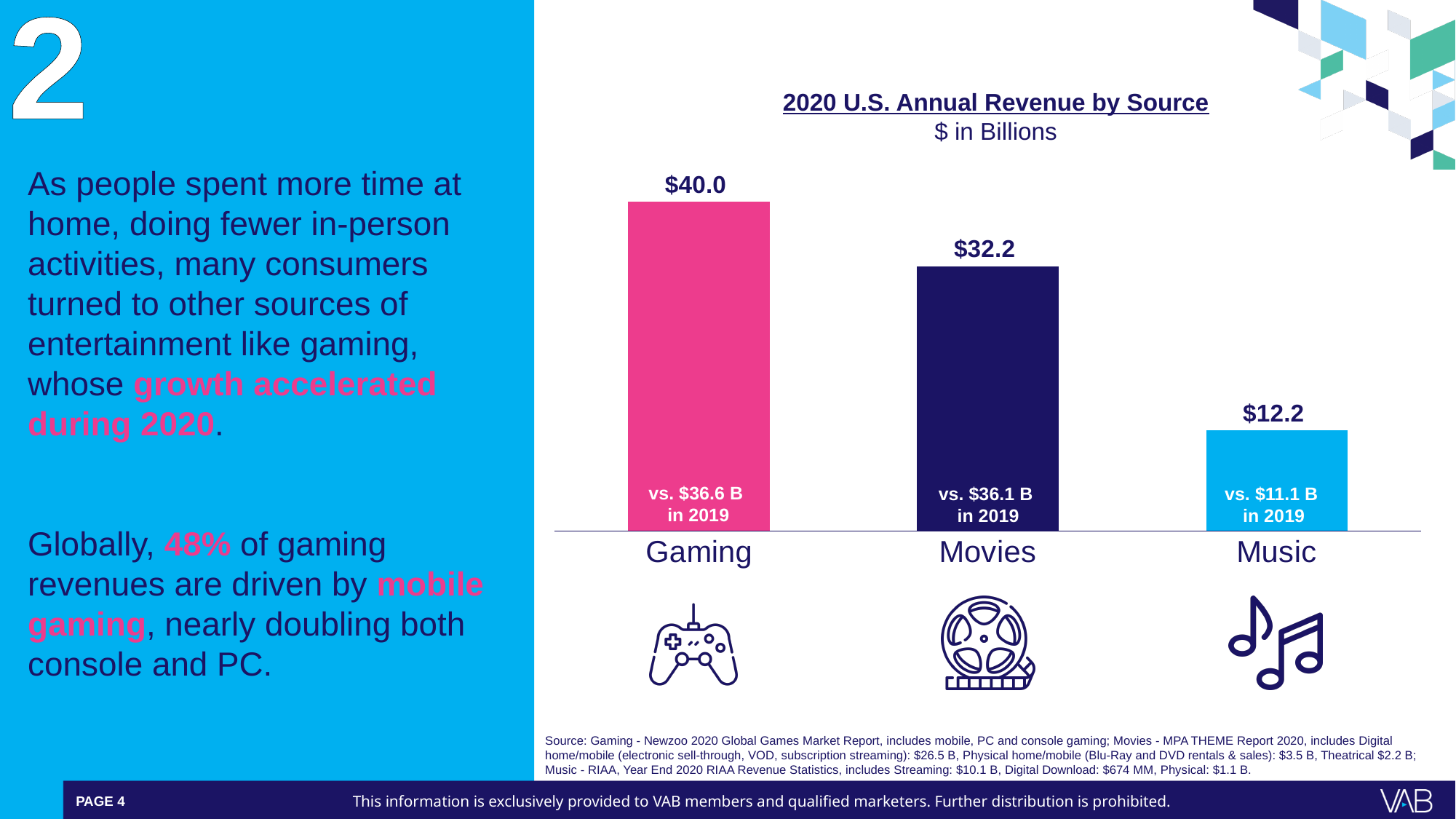
What is the 2020 revenue value shown for Movies? $32.2 What is the difference between the 2020 revenue for Movies and Music? $20.0 What is the 2020 revenue value shown for Music? $12.2 Which source has the highest 2020 revenue? Gaming What is the difference between the 2020 revenue for Gaming and Movies? $7.8 Which source has the lowest 2020 revenue? Music What kind of chart is shown on the slide? Bar chart Which has a larger 2020 revenue, Movies or Music? Movies How many sources are shown in the chart? 3 What is the title of the chart? 2020 U.S. Annual Revenue by Source What was the 2019 revenue for Gaming according to the label inside the bar? $36.6 B What is the 2020 revenue value shown for Gaming? $40.0